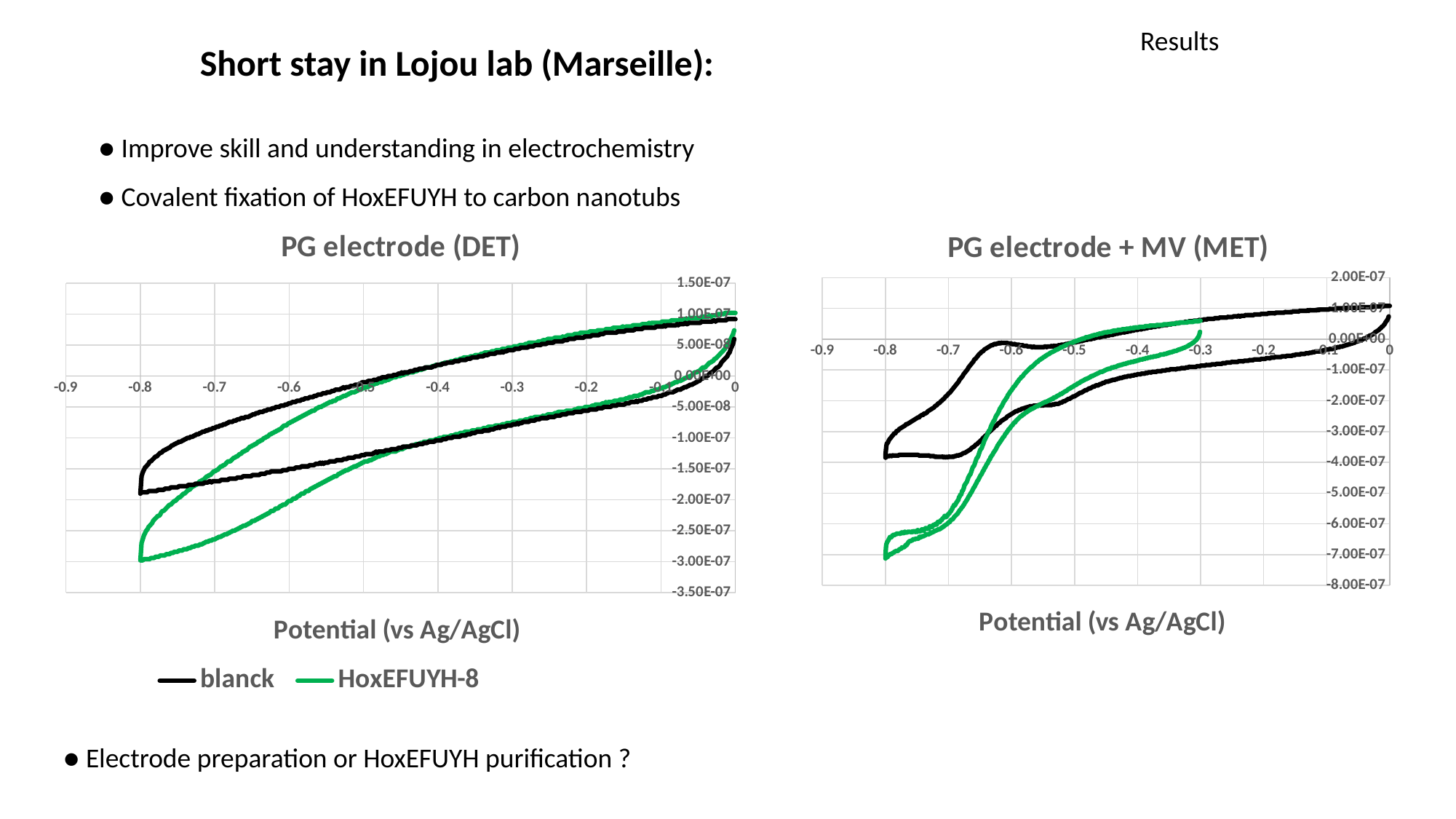
In the "PG electrode + MV (MET)" chart, which series reaches the lower minimum current, blanck or HoxEFUYH-8? HoxEFUYH-8 How many series does the legend list for the charts on the slide? 2 What is the title of the chart on the right side of the slide? PG electrode + MV (MET) What is the highest y-axis tick value shown on the "PG electrode + MV (MET)" chart? 2.00E-07 In the "PG electrode (DET)" chart, which series reaches the lower minimum current, blanck or HoxEFUYH-8? HoxEFUYH-8 In the "PG electrode + MV (MET)" chart, is the lowest value of the HoxEFUYH-8 curve greater or less than -6.00E-07? less What is the x-axis label of the "PG electrode (DET)" chart? Potential (vs Ag/AgCl) In the "PG electrode + MV (MET)" chart, is the lowest value of the blanck curve greater or less than -5.00E-07? greater What is the lowest y-axis tick value shown on the "PG electrode (DET)" chart? -3.50E-07 In the "PG electrode (DET)" chart, is the lowest value of the HoxEFUYH-8 curve greater or less than -2.50E-07? less What kind of chart is the "PG electrode (DET)" chart? line chart